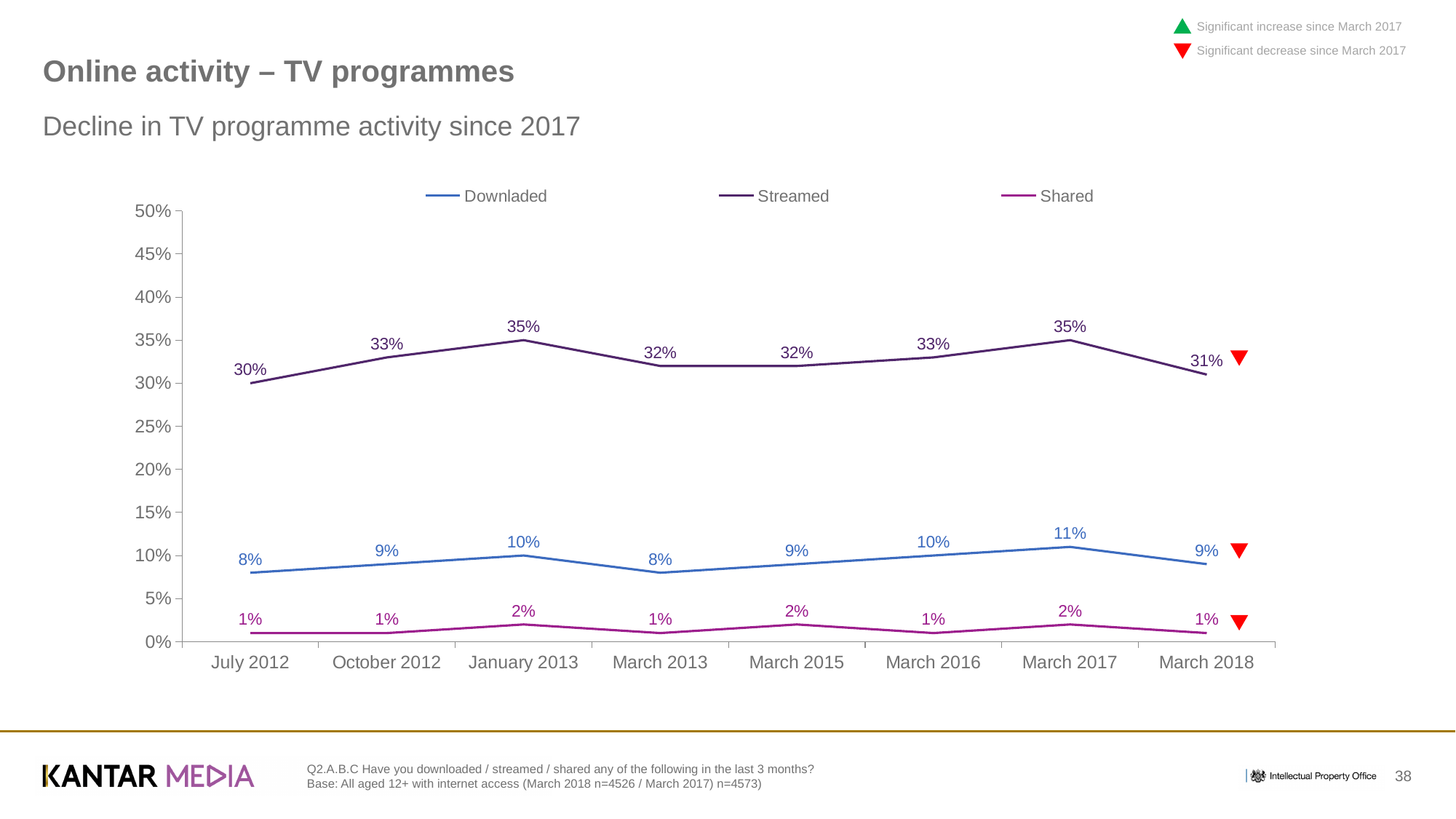
What is the Streamed value for March 2018? 31% What kind of chart is shown on the slide? Line chart In which period does the Streamed series reach its lowest value? July 2012 What is the highest value shown for the Downladed series? 11% What is the Downladed value for March 2017? 11% Did the Streamed value rise or fall from March 2017 to March 2018? Fall How many time periods are shown on the x axis? 8 Which is larger: the Downladed value for October 2012 or for March 2013? October 2012 What is the Shared value for January 2013? 2% How many series does the legend list? 3 What does the red downward triangle next to the March 2018 values indicate? Significant decrease since March 2017 What is the difference between the Streamed values for March 2017 and March 2018? 4%